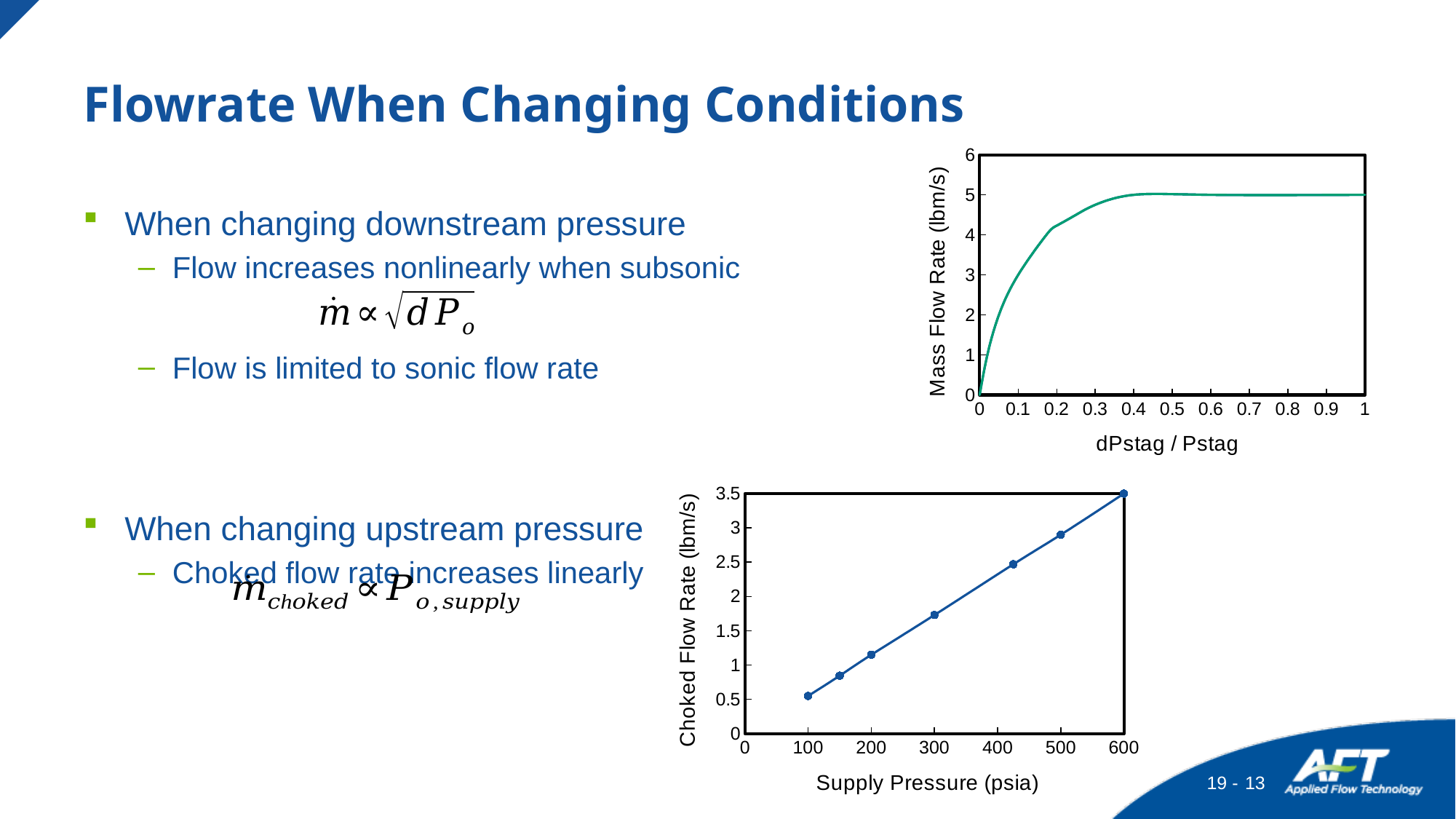
What kind of chart is the top-right chart titled with the y-axis 'Mass Flow Rate (lbm/s)'? line chart In the bottom chart (Choked Flow Rate vs Supply Pressure), what is the choked flow rate at a supply pressure of 600 psia? 3.5 What kind of chart is the bottom chart with the x-axis 'Supply Pressure (psia)'? line chart In the top-right chart (Mass Flow Rate vs dPstag / Pstag), which is larger: the mass flow rate at 0.1 or at 0.5? 0.5 In the top-right chart (Mass Flow Rate vs dPstag / Pstag), is the value at dPstag / Pstag = 0.2 greater or less than 3? greater In the bottom chart (Choked Flow Rate vs Supply Pressure), is the value at 300 psia greater or less than 1.5? greater In the bottom chart (Choked Flow Rate vs Supply Pressure), how many data points are plotted? 7 In the bottom chart (Choked Flow Rate vs Supply Pressure), is the value at 100 psia greater or less than 1? less What is the x-axis label of the top-right chart? dPstag / Pstag In the bottom chart (Choked Flow Rate vs Supply Pressure), does the choked flow rate rise or fall as supply pressure increases? rise